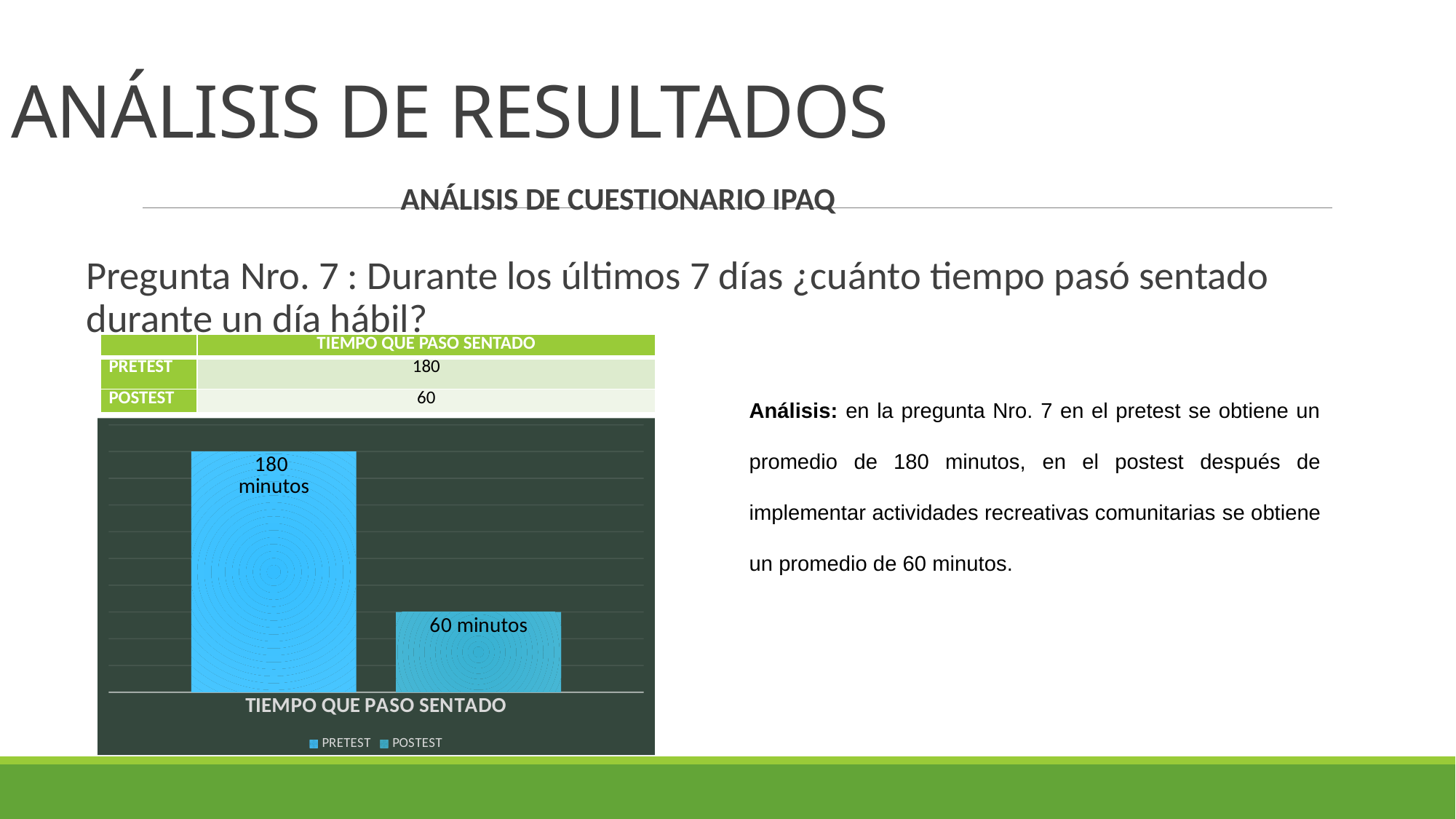
How many series does the chart legend list? 2 Does the value fall or rise from PRETEST to POSTEST? fall What are the two entries in the chart legend? PRETEST and POSTEST What is the value for PRETEST in the chart? 180 minutos Which series has the higher value, PRETEST or POSTEST? PRETEST What is the category label shown on the x axis of the chart? TIEMPO QUE PASO SENTADO What is the value for POSTEST in the chart? 60 minutos Which series has the lowest value in the chart? POSTEST How many bars are plotted in the chart? 2 What is the difference in minutes between the PRETEST and POSTEST values? 120 What kind of chart is shown on the slide? bar chart